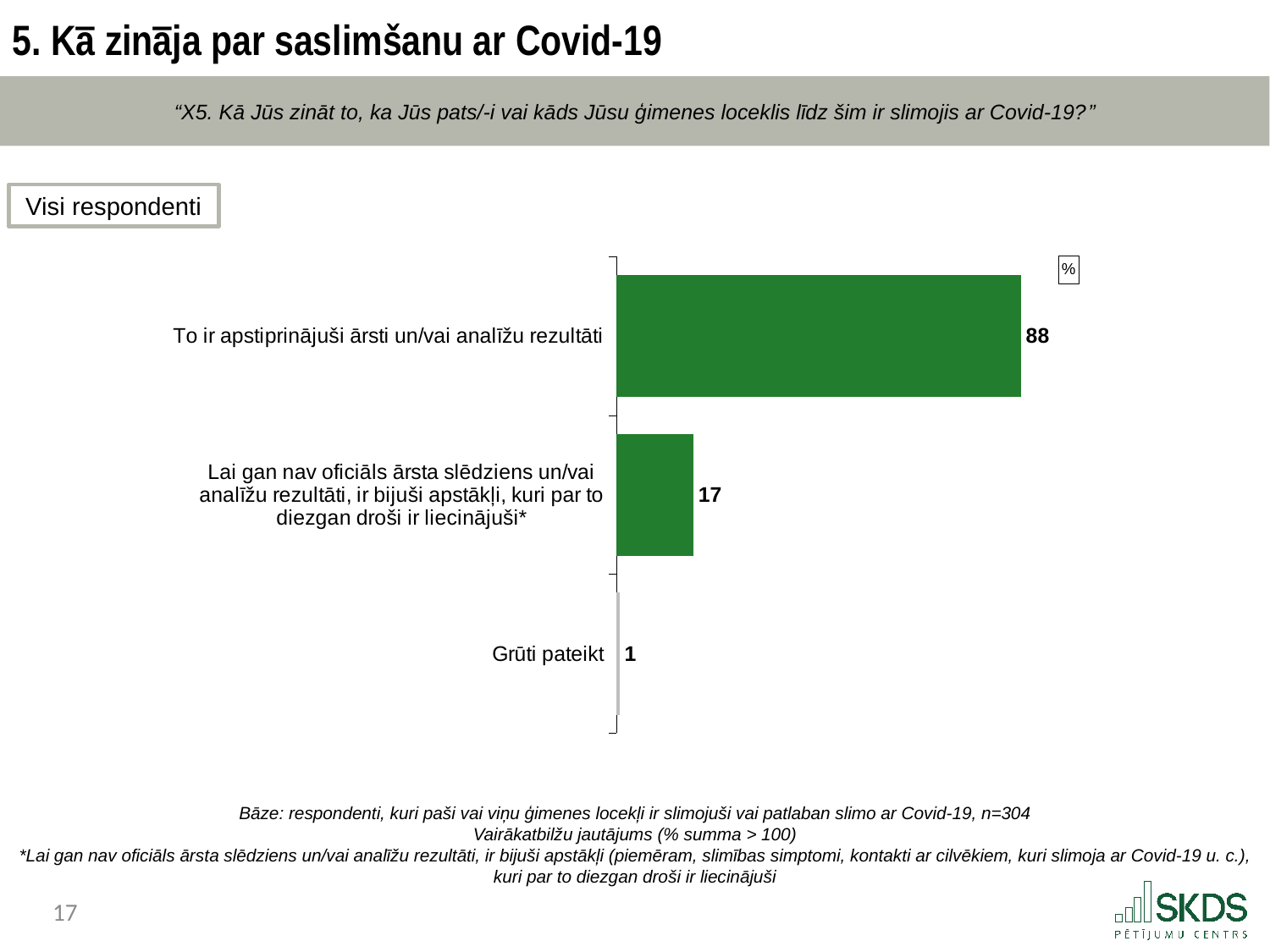
What kind of chart is shown on the slide? Bar chart What unit is indicated in the top-right corner of the chart? % What is the value for "To ir apstiprinājuši ārsti un/vai analīžu rezultāti"? 88 What is the label of the box above the chart indicating the respondent group? Visi respondenti What is the difference between the value for "To ir apstiprinājuši ārsti un/vai analīžu rezultāti" and the value for "Lai gan nav oficiāls ārsta slēdziens un/vai analīžu rezultāti..."? 71 What is the value for the category beginning "Lai gan nav oficiāls ārsta slēdziens"? 17 What is the difference between the value for "Lai gan nav oficiāls ārsta slēdziens..." and the value for "Grūti pateikt"? 16 What is the value for "Grūti pateikt"? 1 How many categories are shown in the chart? 3 Which category has the highest value? To ir apstiprinājuši ārsti un/vai analīžu rezultāti Which category has the lowest value? Grūti pateikt Which is larger: the value for "Grūti pateikt" or the value for "Lai gan nav oficiāls ārsta slēdziens..."? Lai gan nav oficiāls ārsta slēdziens...